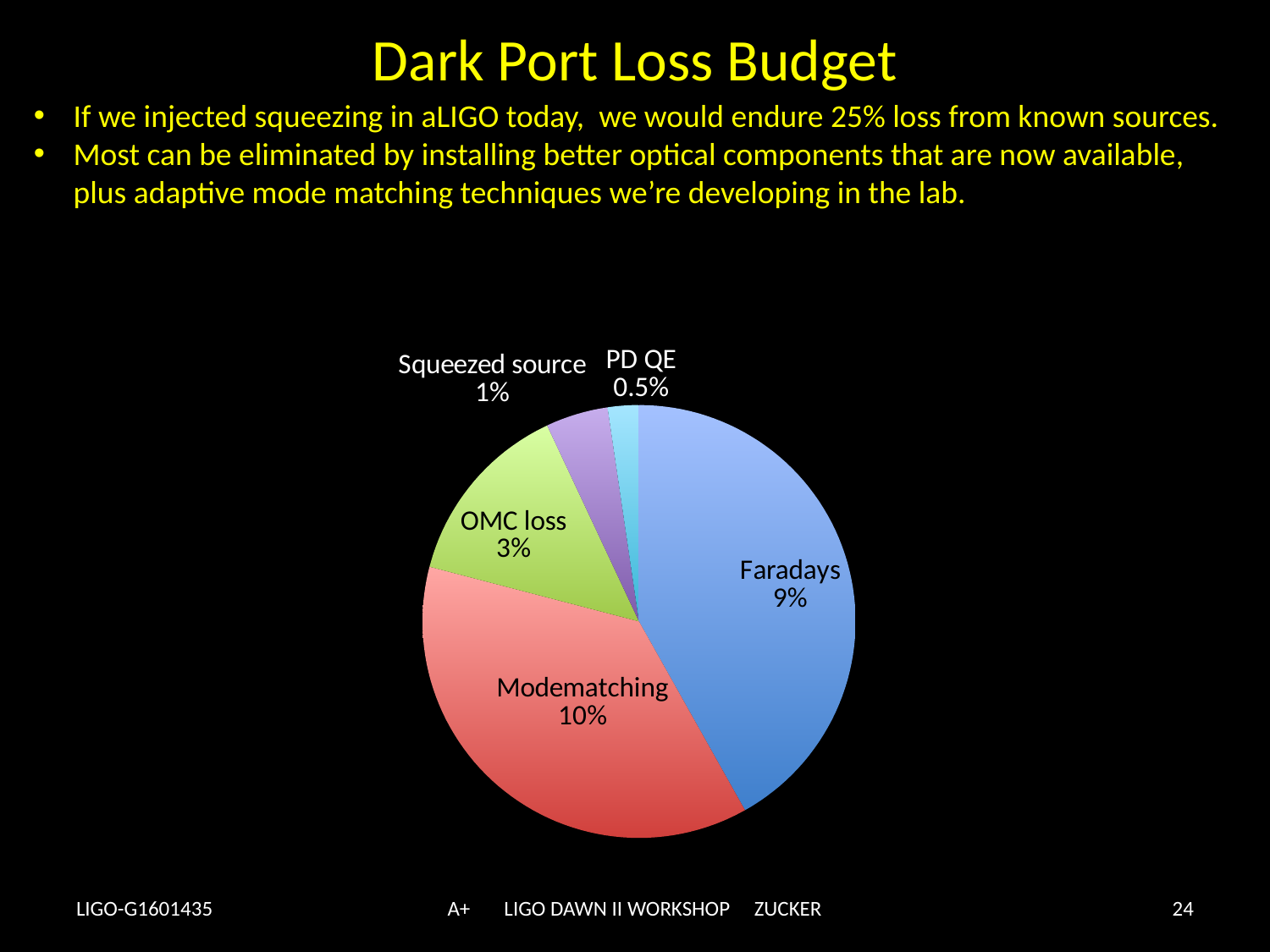
Which is larger, the OMC loss value or the Squeezed source value? OMC loss How many slices does the pie chart have? 5 What colour is the Modematching slice? red What value is labelled for the PD QE slice? 0.5% Which slice of the pie chart has the smallest value? PD QE What value is labelled for the Squeezed source slice? 1% What value is labelled for the Faradays slice? 9% What value is labelled for the Modematching slice? 10% What kind of chart is shown on the slide? pie chart What value is labelled for the OMC loss slice? 3% What is the difference between the Modematching and Faradays values? 1%